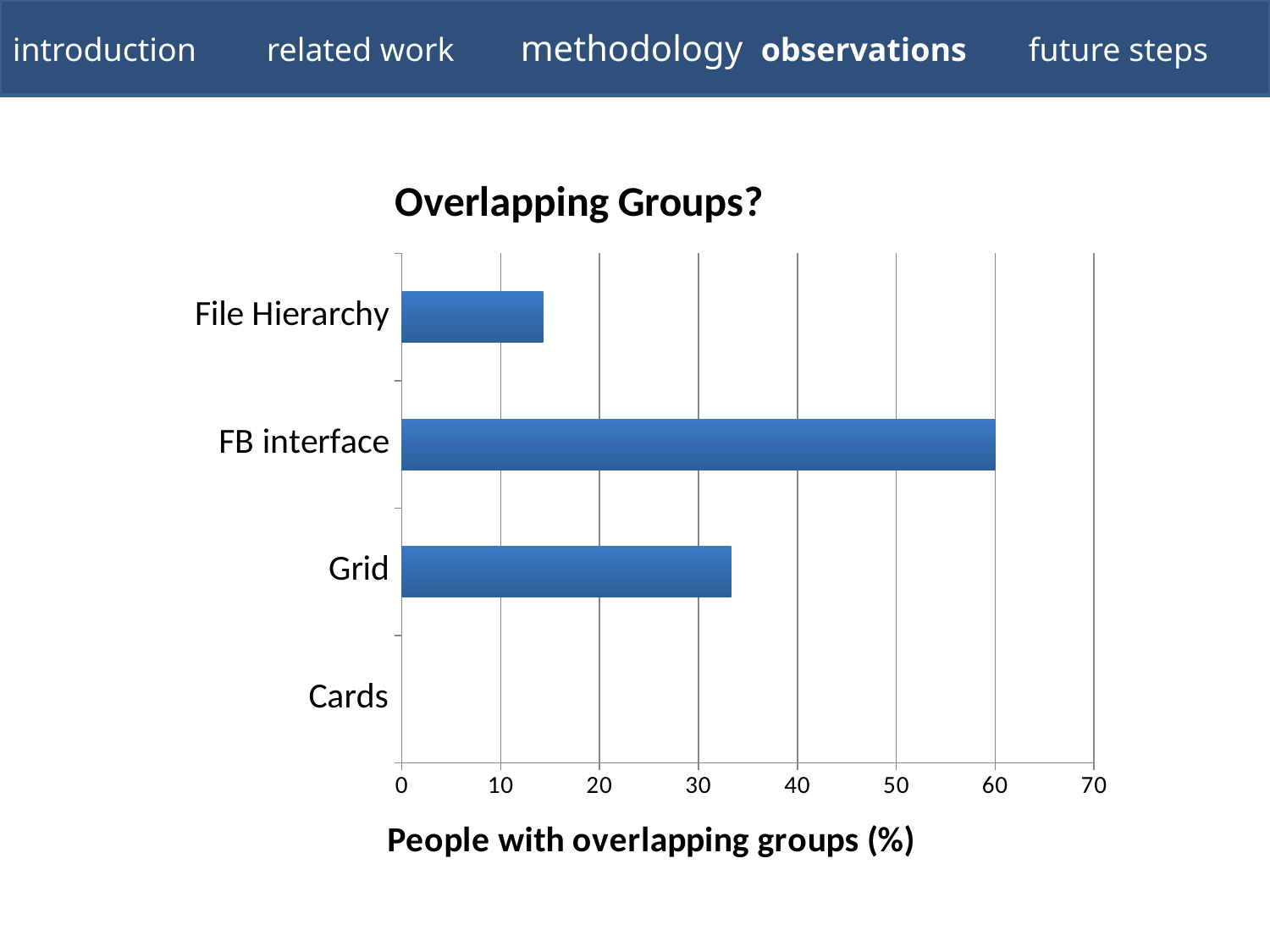
What is the value for FB interface? 60 How many categories are plotted in the chart? 4 Is the value for Grid greater or less than 30? greater Is the value for File Hierarchy greater or less than 20? less Is the value for File Hierarchy greater or less than 10? greater What kind of chart is shown on the slide? bar chart What is the value for Cards? 0 Which category has the highest percentage of people with overlapping groups? FB interface Which has a larger value, Grid or File Hierarchy? Grid Which category has the lowest percentage of people with overlapping groups? Cards What is the title of the chart? Overlapping Groups? What is the label of the horizontal axis? People with overlapping groups (%)